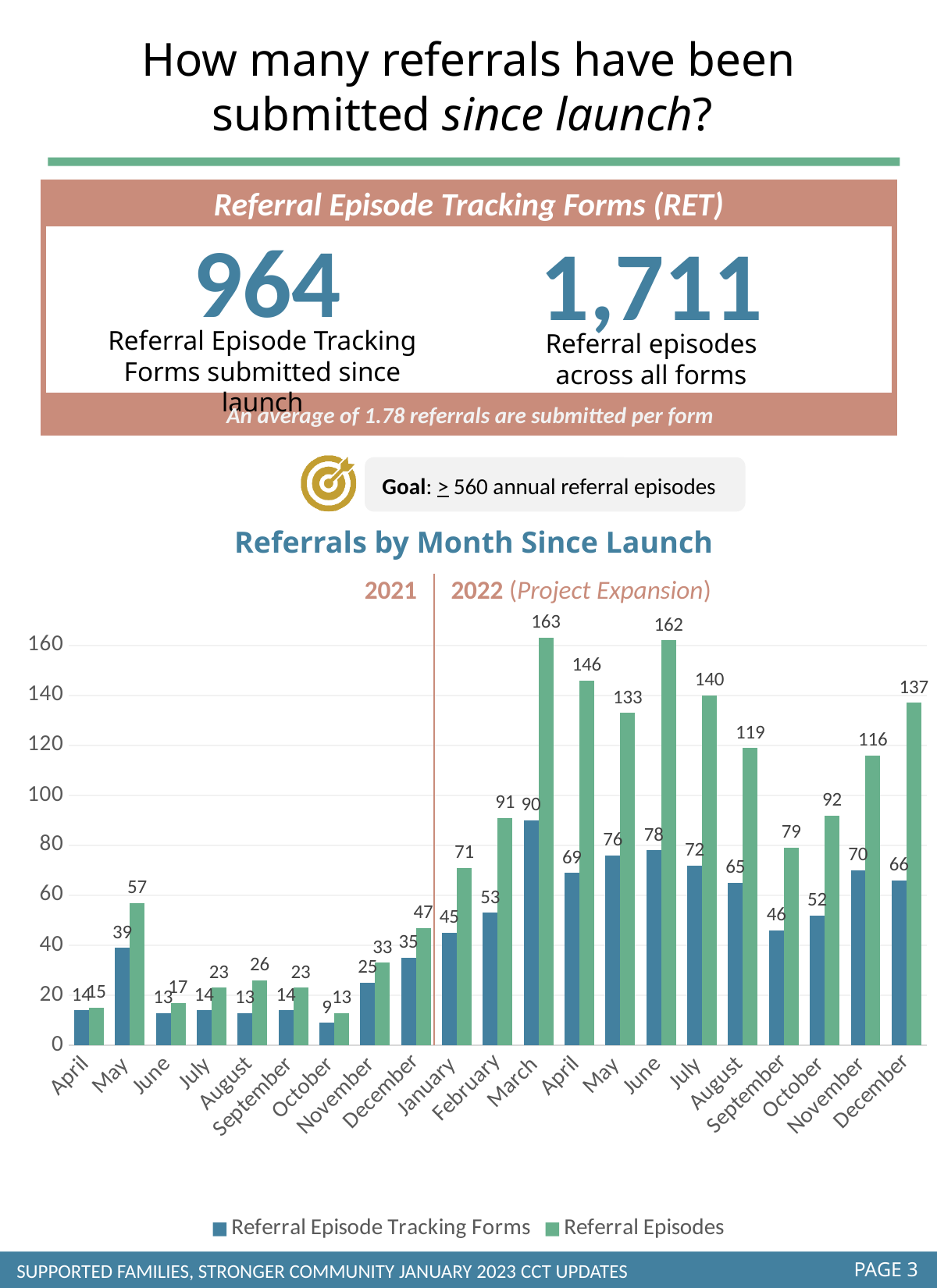
In the "Referrals by Month Since Launch" chart, which month has the highest number of Referral Episode Tracking Forms? March 2022 How many series does the legend of the "Referrals by Month Since Launch" chart list? 2 In the "Referrals by Month Since Launch" chart, what colour are the Referral Episodes bars? green In the "Referrals by Month Since Launch" chart, is the value for Referral Episodes in November 2022 greater or less than 100? greater In the "Referrals by Month Since Launch" chart, which is larger: Referral Episodes in July 2022 or Referral Episodes in December 2022? July 2022 In the "Referrals by Month Since Launch" chart, what is the difference between Referral Episodes and Referral Episode Tracking Forms in April 2022? 77 What type of chart is "Referrals by Month Since Launch"? bar chart In the "Referrals by Month Since Launch" chart, do Referral Episodes rise or fall from October 2021 to March 2022? rise In the "Referrals by Month Since Launch" chart, which month has the lowest number of Referral Episodes? October 2021 In the "Referrals by Month Since Launch" chart, how many Referral Episodes were there in March 2022? 163 In the "Referrals by Month Since Launch" chart, how many Referral Episode Tracking Forms were submitted in October 2021? 9 How many months are shown on the x axis of the "Referrals by Month Since Launch" chart? 21